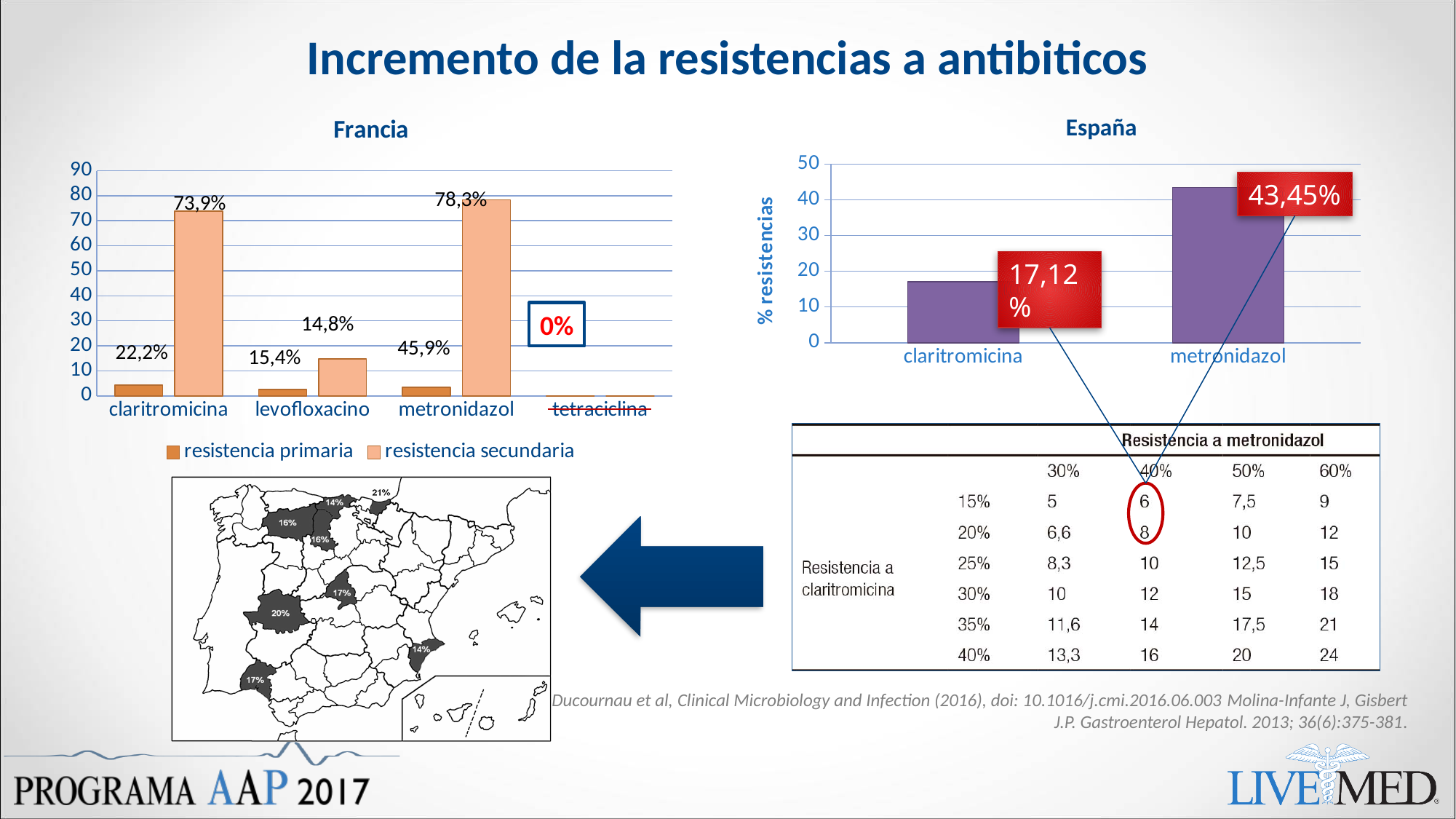
In the Francia chart, which antibiotic has the highest resistencia secundaria? metronidazol In the Francia chart, is resistencia secundaria higher for claritromicina or for levofloxacino? claritromicina In the España chart, what is the value for metronidazol? 43,45% In the España chart, what is the difference in percentage points between metronidazol and claritromicina? 26,33 In the España chart, what is the value for claritromicina? 17,12% How many antibiotic categories are shown on the x axis of the Francia chart? 4 What is the y-axis title of the España chart? % resistencias In the Francia chart, what is the resistencia secundaria value for metronidazol? 78,3% How many series does the legend of the Francia chart list? 2 In the Francia chart, what is the resistencia secundaria value for claritromicina? 73,9% What kind of chart is the Francia chart? bar chart In the Francia chart, what is the difference in percentage points between the resistencia secundaria values for metronidazol and claritromicina? 4,4